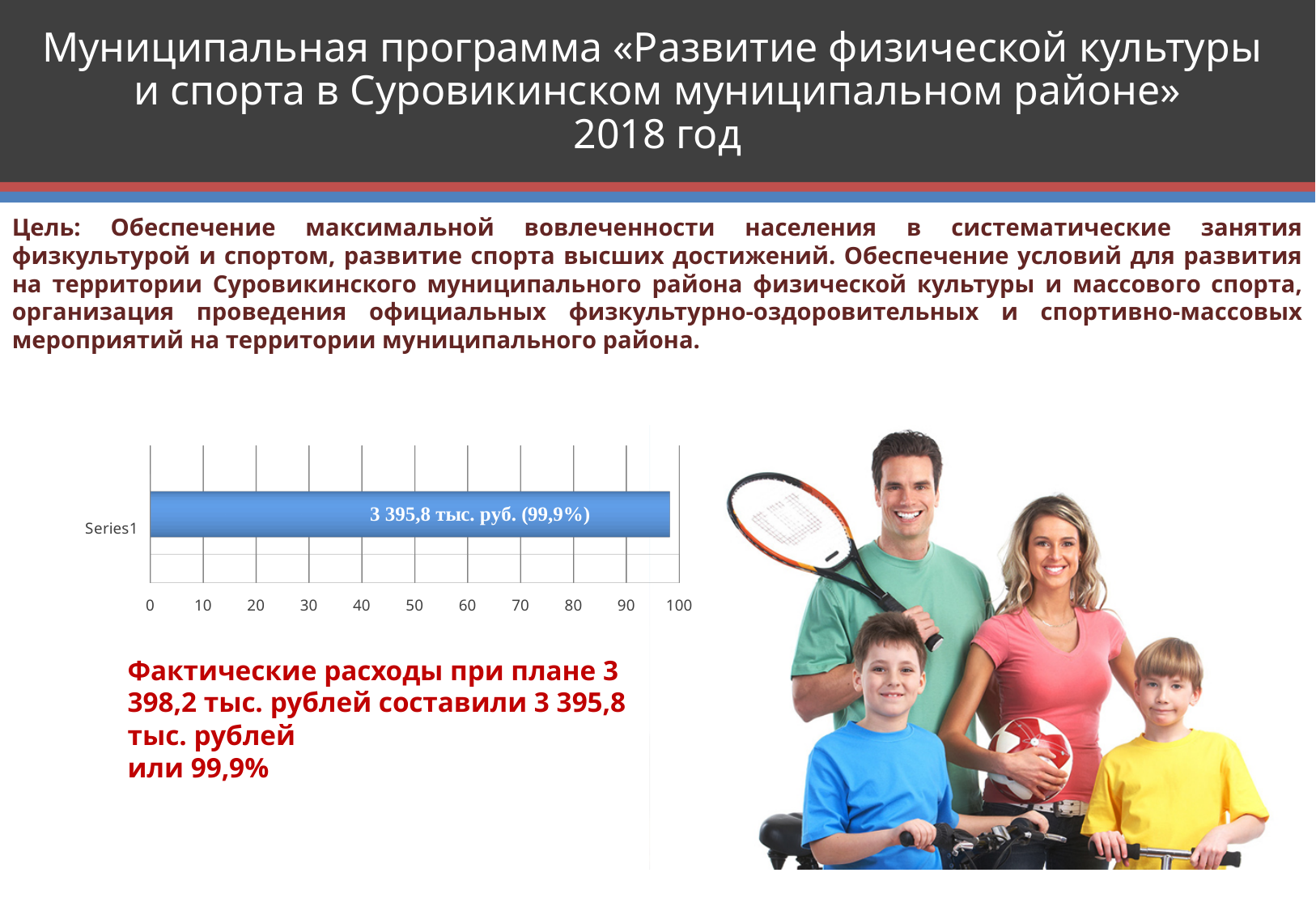
What kind of chart is shown on the slide? bar chart What is the category label shown next to the bar? Series1 What is the data label printed on the bar in the chart? 3 395,8 тыс. руб. (99,9%) What percentage is shown in the data label on the bar? 99,9% What amount in thousand rubles is shown in the data label on the bar? 3 395,8 тыс. руб. Are the bars in the chart horizontal or vertical? horizontal Is the value of the bar greater or less than 90 on the axis? greater What is the maximum value shown on the horizontal axis of the chart? 100 Is the value of the bar greater or less than 50 on the axis? greater How many bars does the chart contain? 1